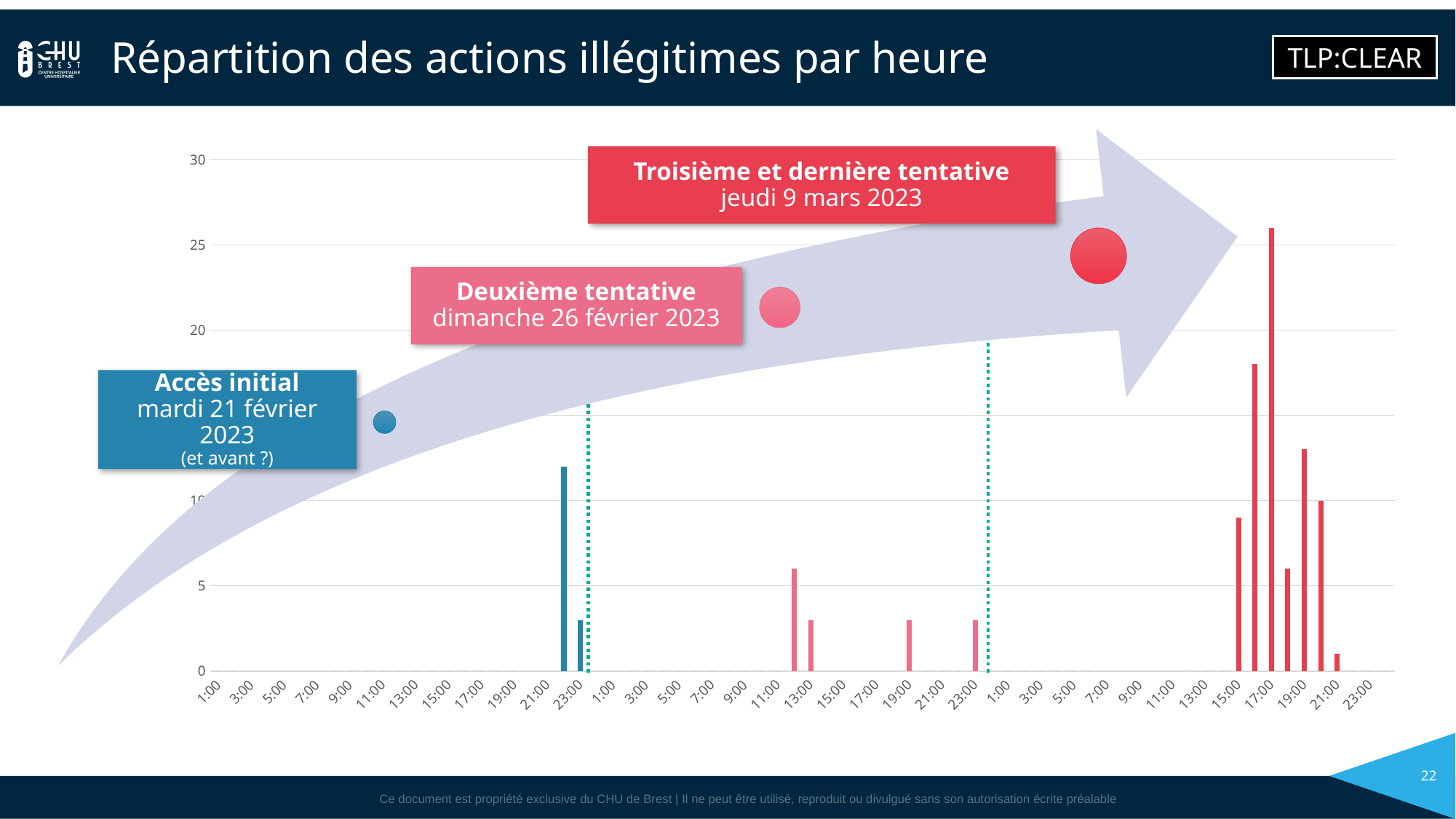
Is the tallest bar on the chart greater or less than 20? greater What kind of chart is shown on the slide? bar chart Is the tallest blue bar (Accès initial) greater or less than 15? less What is the title of the chart on the slide? Répartition des actions illégitimes par heure Is the tallest blue bar (Accès initial) greater or less than 10? greater Which annotated attempt contains the tallest bar on the chart? Troisième et dernière tentative (jeudi 9 mars 2023) Which is larger: the tallest bar of the Accès initial or the tallest bar of the Deuxième tentative? Accès initial What is the highest value shown on the vertical axis of the chart? 30 How many attempts (tentatives) are annotated with labelled boxes on the chart? 3 Which is larger: the tallest bar of the Troisième et dernière tentative or the tallest bar of the Accès initial? Troisième et dernière tentative